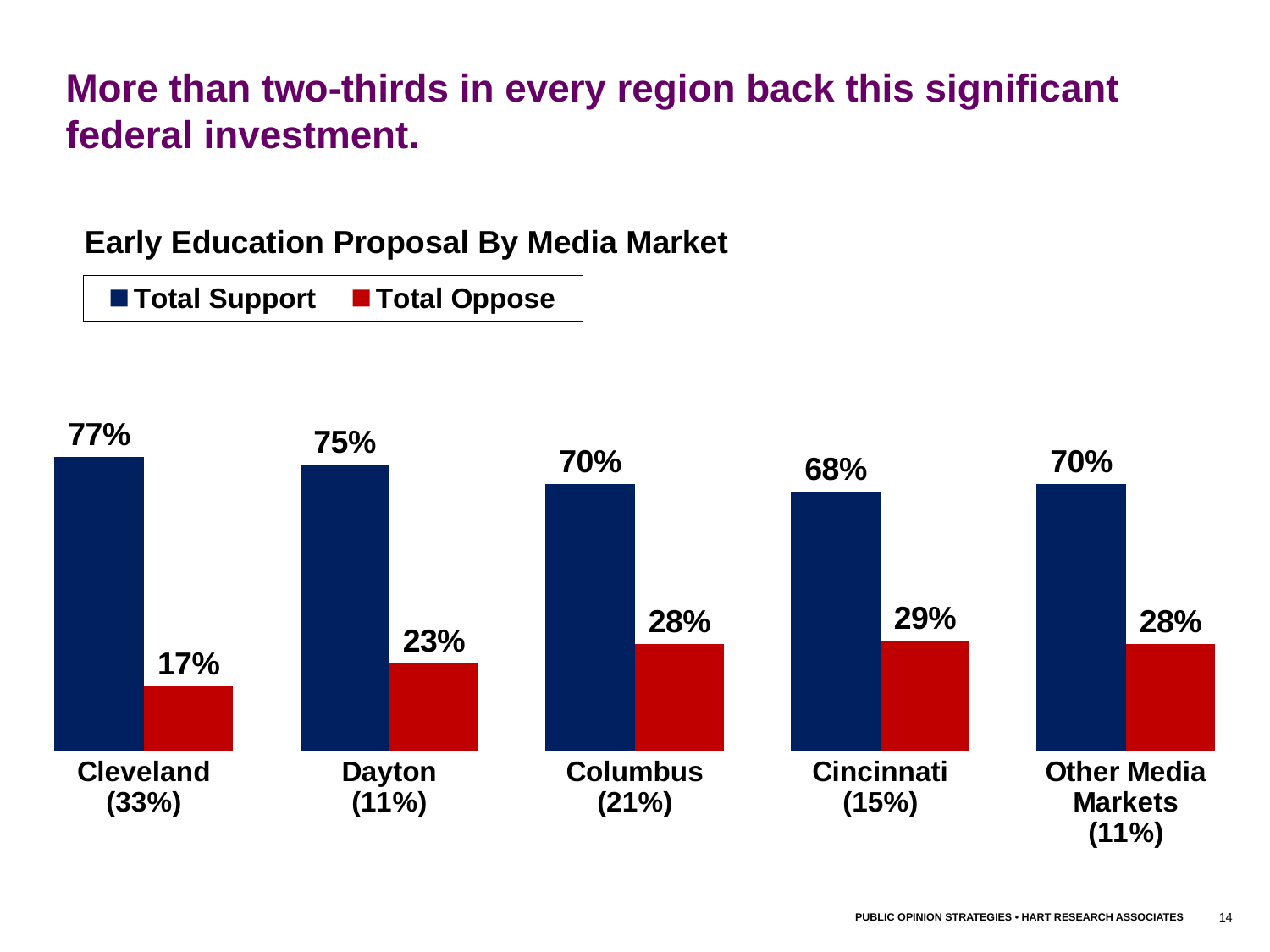
What is the difference in Total Support between Cleveland and Dayton? 2% Which media market has the highest Total Support? Cleveland How many series does the legend list? 2 What is the Total Oppose value for Dayton? 23% Which media market has the lowest Total Support? Cincinnati What is the Total Support value for Cleveland? 77% What type of chart is shown on the slide? Bar chart What is the difference between Total Support and Total Oppose for Columbus? 42% Which media market has the lowest Total Oppose? Cleveland What is the Total Oppose value for Cincinnati? 29% How many media markets are shown on the chart? 5 Which is larger, Total Oppose for Dayton or Total Oppose for Other Media Markets? Other Media Markets